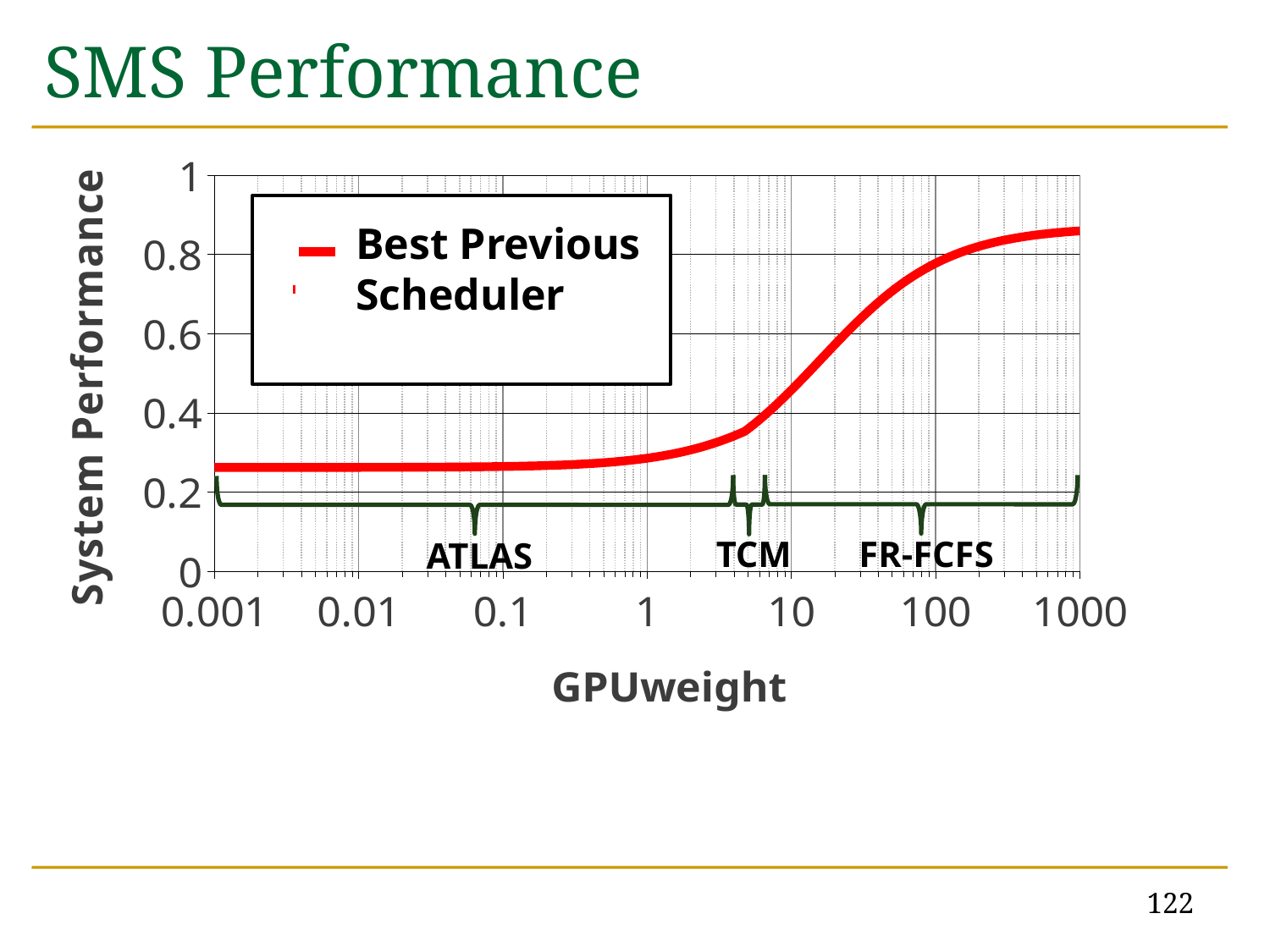
Is the System Performance value at GPUweight 0.001 greater or less than 0.2? greater Is the System Performance value at GPUweight 0.001 greater or less than 0.4? less What kind of chart is shown on the slide? line chart Which has the higher System Performance: GPUweight 0.01 or GPUweight 1000? GPUweight 1000 Is the System Performance value at GPUweight 1000 greater or less than 0.8? greater What is the name of the series shown in the legend? Best Previous Scheduler Does System Performance rise or fall as GPUweight increases along the x axis? rise What is the title of the y axis? System Performance How many series does the legend list? 1